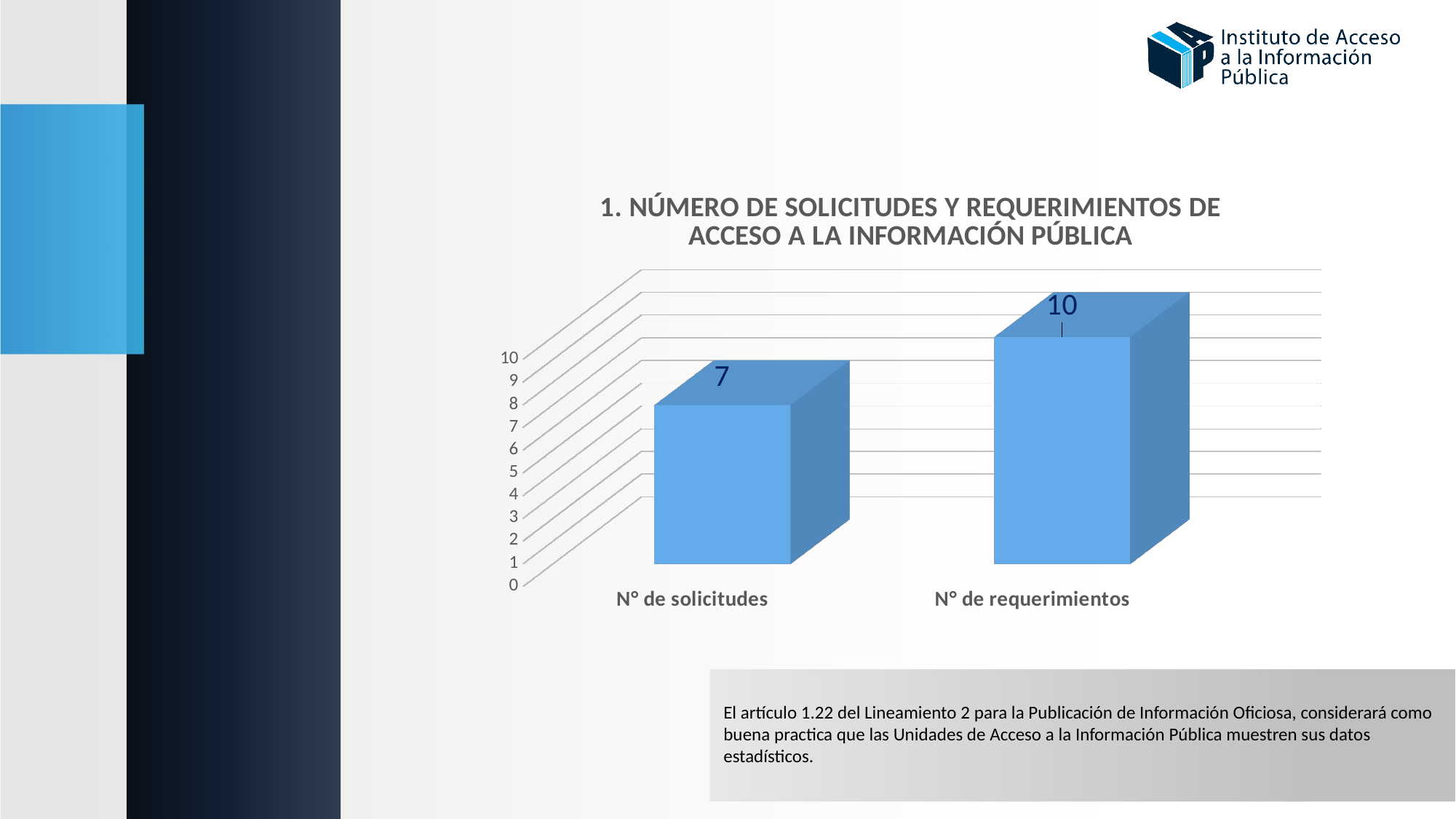
How many categories are shown in the chart? 2 What is the value for N° de requerimientos? 10 Which is larger, N° de solicitudes or N° de requerimientos? N° de requerimientos What is the title of the chart? 1. NÚMERO DE SOLICITUDES Y REQUERIMIENTOS DE ACCESO A LA INFORMACIÓN PÚBLICA What kind of chart is shown on the slide? Bar chart Is the value for N° de solicitudes greater or less than 5? greater What is the maximum value shown on the vertical axis? 10 Which category has the lowest value? N° de solicitudes What is the value for N° de solicitudes? 7 What is the difference between N° de requerimientos and N° de solicitudes? 3 Which category has the highest value? N° de requerimientos